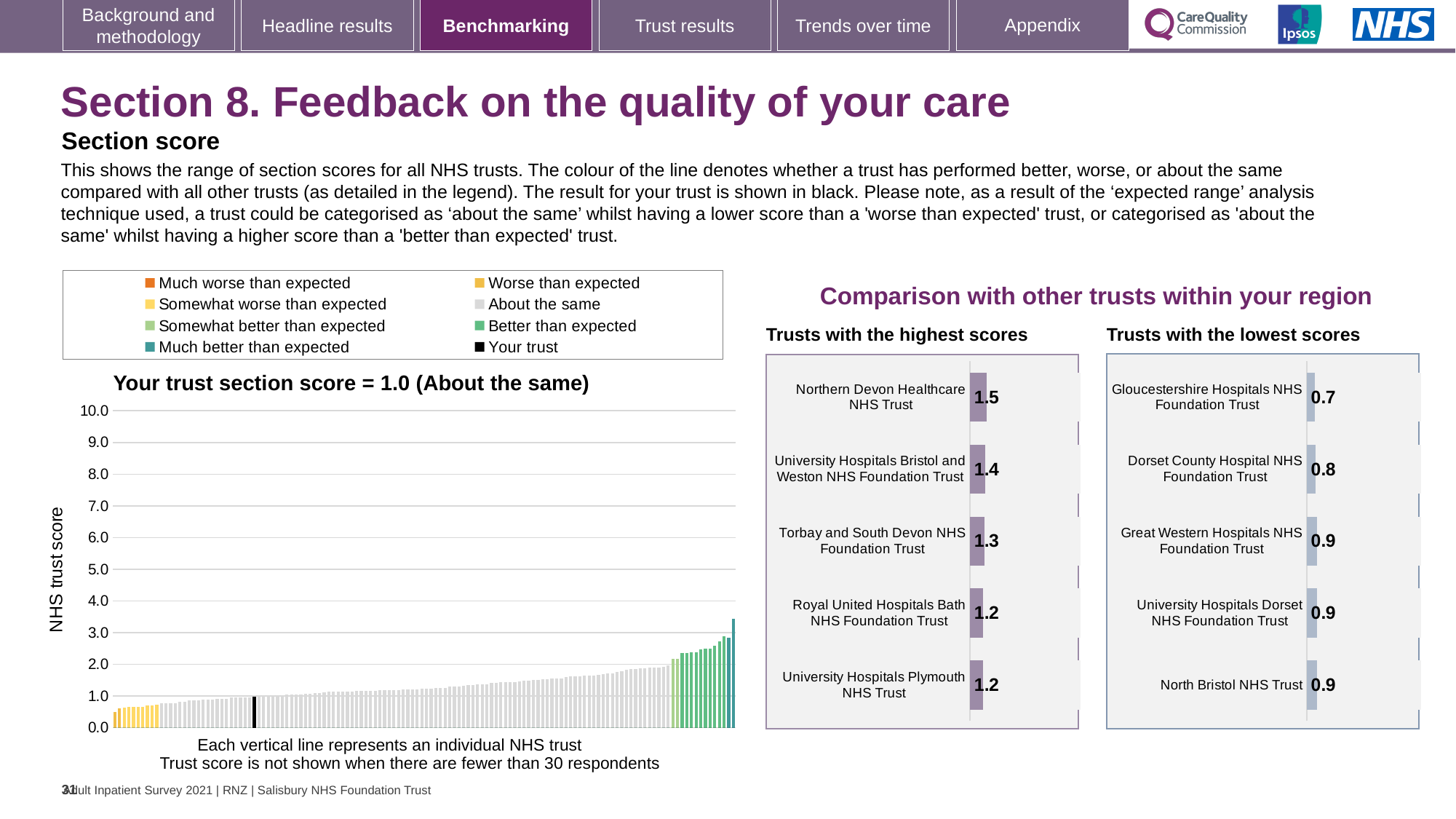
In the 'Trusts with the highest scores' chart, what is the score for Torbay and South Devon NHS Foundation Trust? 1.3 In the 'Trusts with the lowest scores' chart, what is the score for Dorset County Hospital NHS Foundation Trust? 0.8 In the 'Trusts with the highest scores' chart, what is the difference between the scores of Northern Devon Healthcare NHS Trust and Torbay and South Devon NHS Foundation Trust? 0.2 In the main chart on the left, is the value of the tallest bar greater or less than 3.0? greater In the 'Trusts with the lowest scores' chart, which has the larger score: Dorset County Hospital NHS Foundation Trust or Gloucestershire Hospitals NHS Foundation Trust? Dorset County Hospital NHS Foundation Trust In the 'Trusts with the highest scores' chart, what is the score for Northern Devon Healthcare NHS Trust? 1.5 In the 'Trusts with the highest scores' chart, which trust has the highest score? Northern Devon Healthcare NHS Trust In the 'Trusts with the lowest scores' chart, what is the score for Gloucestershire Hospitals NHS Foundation Trust? 0.7 What kind of chart is the main chart on the left titled 'Your trust section score = 1.0 (About the same)'? bar chart How many trusts are shown in the 'Trusts with the highest scores' chart? 5 According to the title of the main chart on the left, what is your trust's section score? 1.0 In the 'Trusts with the lowest scores' chart, which trust has the lowest score? Gloucestershire Hospitals NHS Foundation Trust